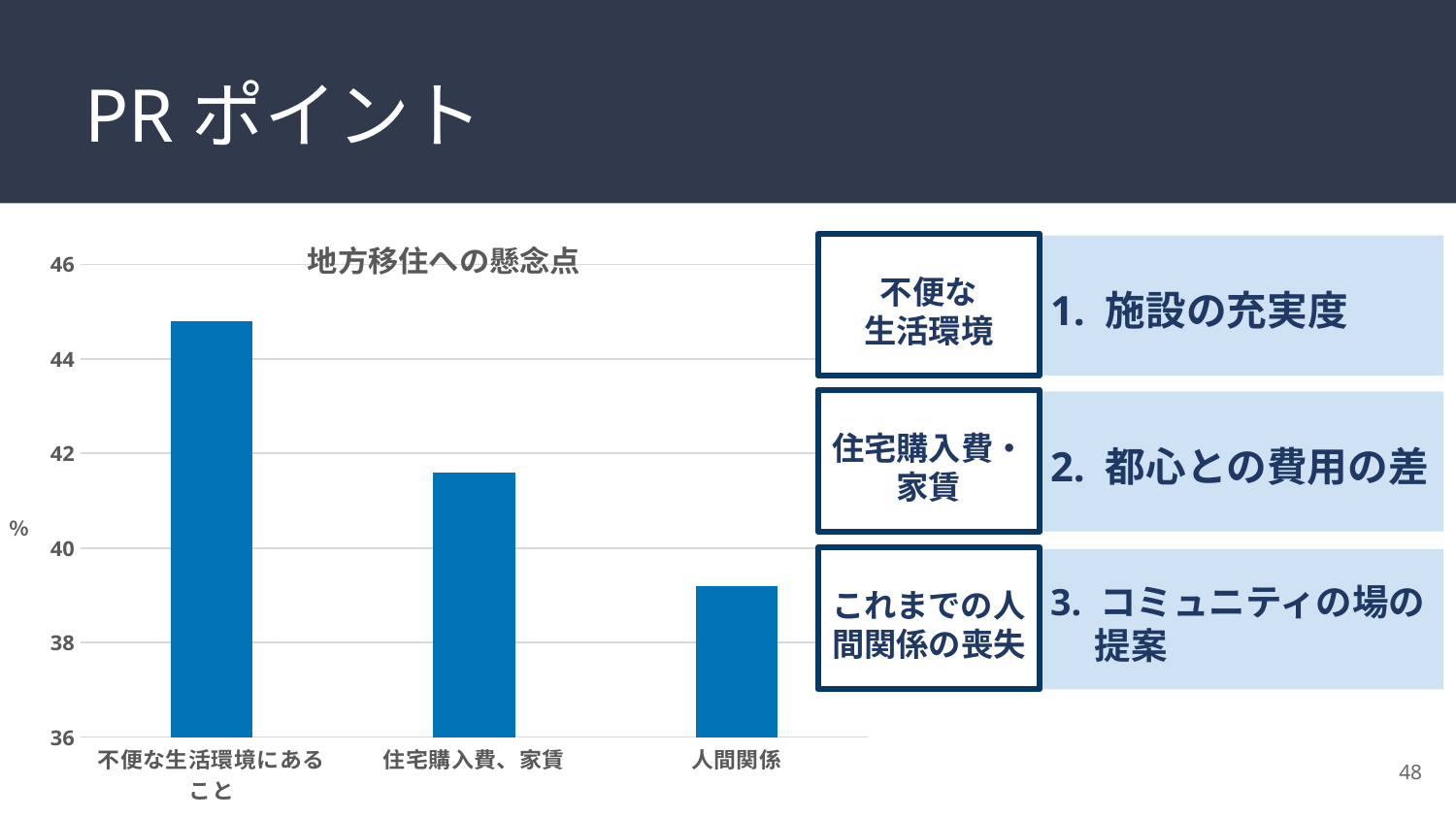
What type of chart is shown on the slide? bar chart Do the bar values rise or fall from left to right across the categories? fall Is the value for 住宅購入費、家賃 greater or less than 42? less Is the value for 人間関係 greater or less than 38? greater What unit is shown on the y-axis of the chart? % What is the title of the chart? 地方移住への懸念点 Which category has the highest value in the chart? 不便な生活環境にあること Which is larger, the value for 住宅購入費、家賃 or the value for 人間関係? 住宅購入費、家賃 Is the value for 人間関係 greater or less than 40? less How many categories are plotted in the chart? 3 Which category has the lowest value in the chart? 人間関係